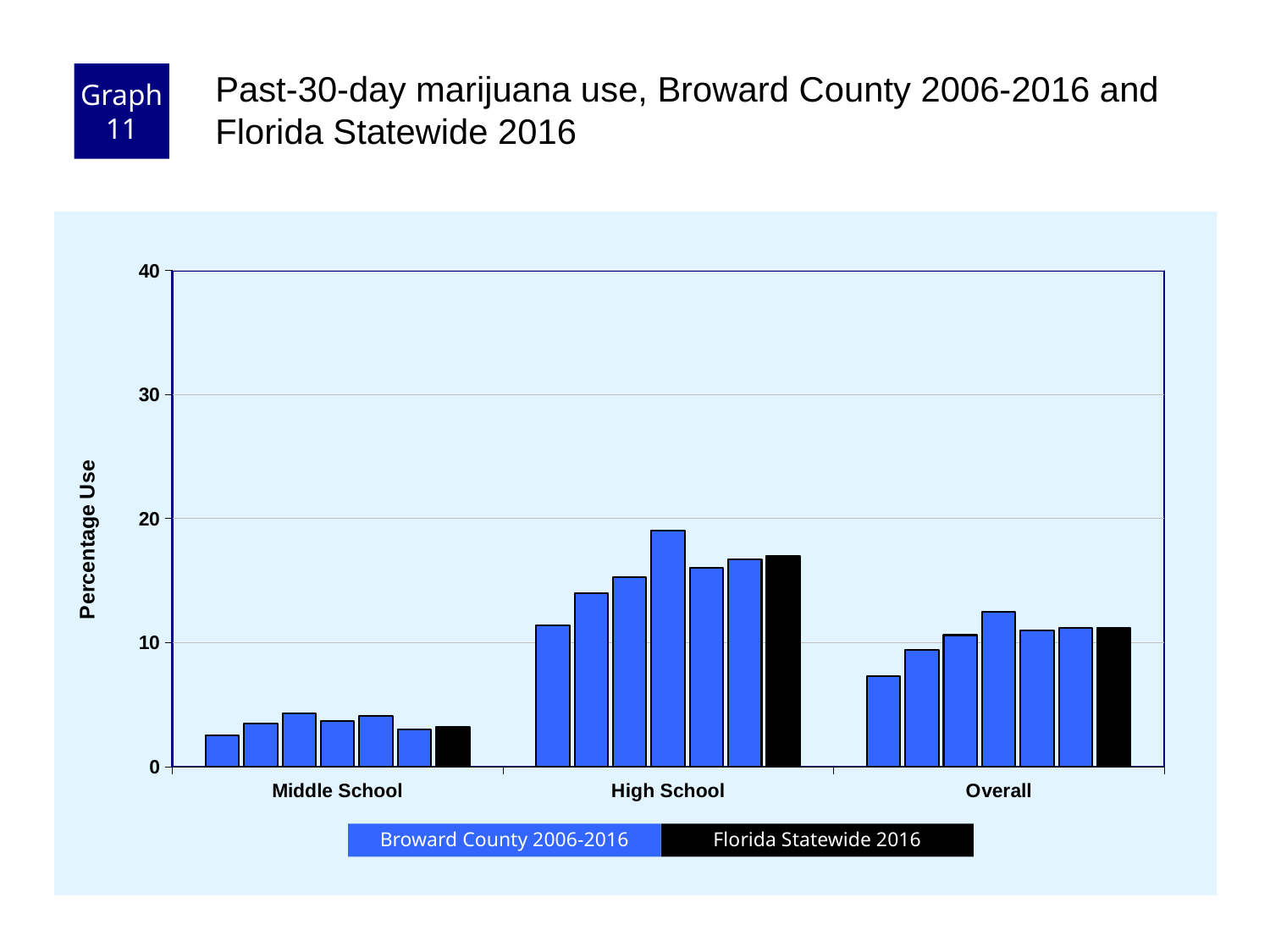
Is the Florida Statewide 2016 value for Middle School greater or less than 10? less Is the Florida Statewide 2016 value for High School greater or less than 20? less How many categories are shown on the x axis? 3 What is the title of the y axis? Percentage Use How many series does the legend list? 2 Which category has the shortest bars? Middle School Which is larger: the Florida Statewide 2016 value for High School or for Overall? High School Which category has the tallest bars? High School Is the tallest Broward County bar for High School greater or less than 20? less What kind of chart is shown on the slide? Bar chart What colour are the Florida Statewide 2016 bars? Black